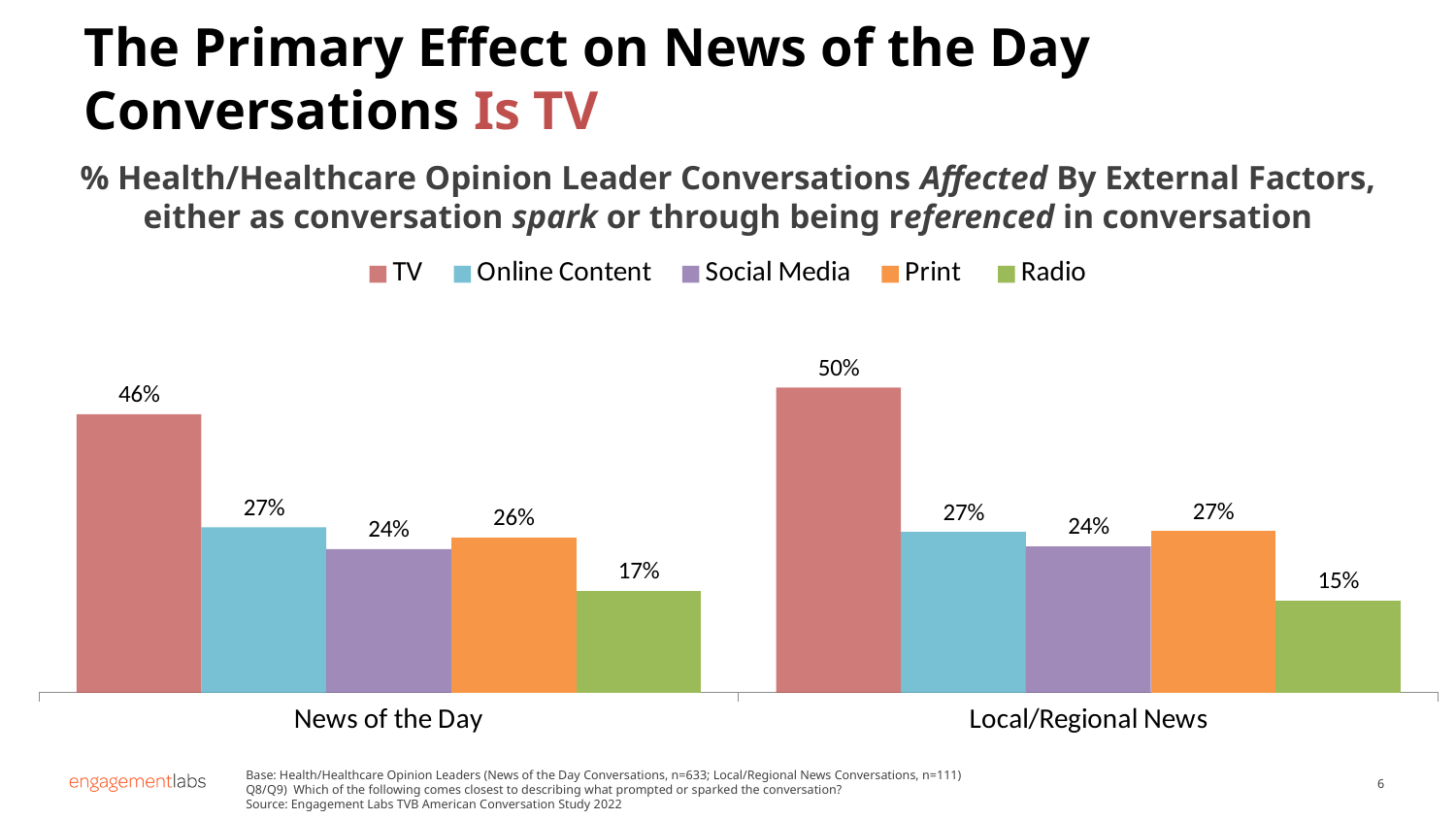
What is the value for Radio in the Local/Regional News category? 15% Which series is shown in orange in the legend? Print What is the difference between the TV values for Local/Regional News and News of the Day? 4% What kind of chart is shown on the slide? Bar chart Which series has the lowest value in the News of the Day category? Radio How many categories are shown on the x axis? 2 What is the value for Print in the News of the Day category? 26% What is the value for TV in the News of the Day category? 46% Which series has the highest value in the Local/Regional News category? TV How many series does the legend list? 5 Which is larger: Social Media for News of the Day or Print for News of the Day? Print for News of the Day What is the difference between the TV and Radio values in the Local/Regional News category? 35%